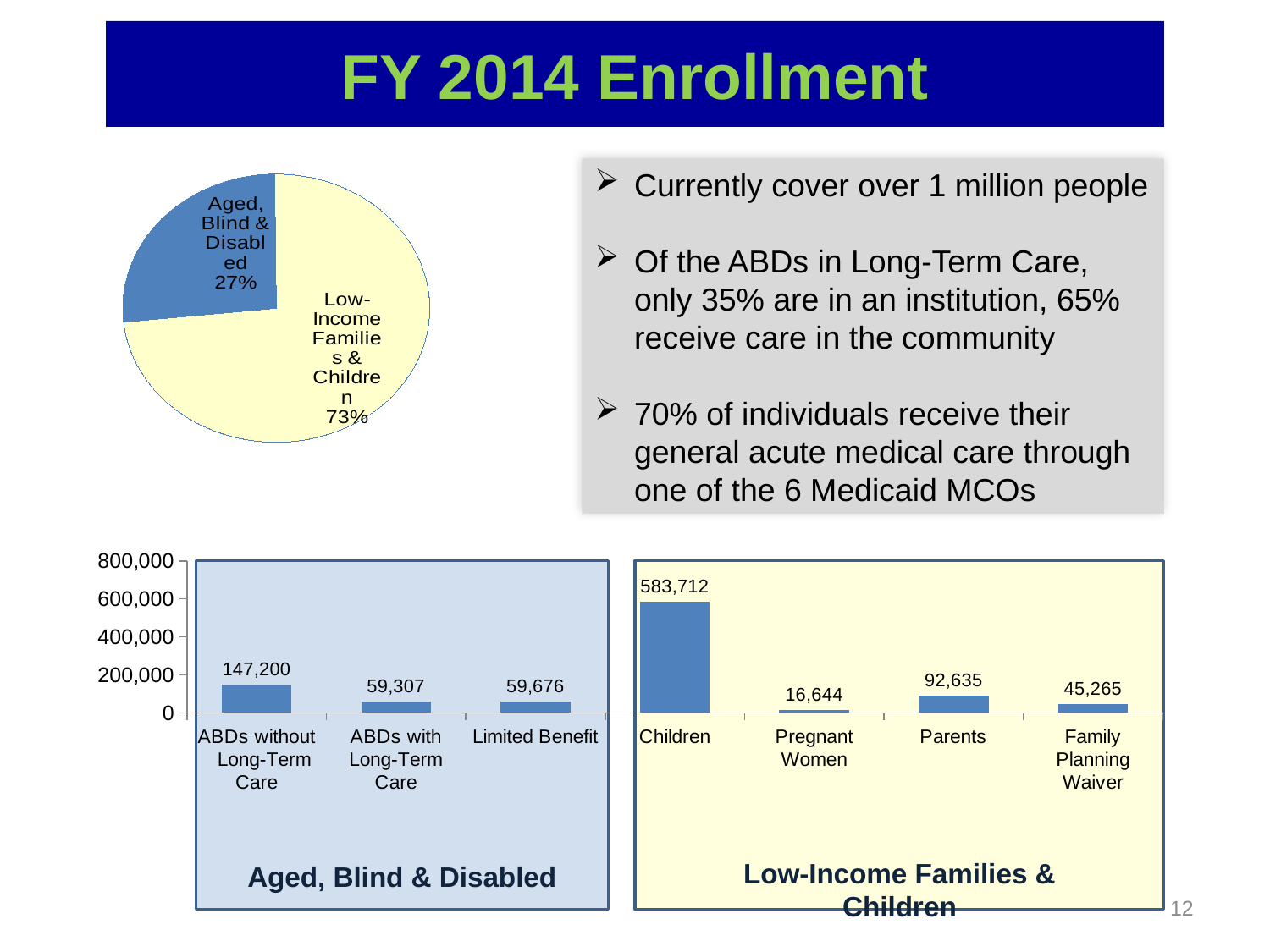
In the pie chart at the top left, which slice is larger, Aged, Blind & Disabled or Low-Income Families & Children? Low-Income Families & Children In the pie chart at the top left, what share of enrollment is Aged, Blind & Disabled? 27% In the bar chart at the bottom, how many categories are plotted? 7 In the bar chart at the bottom, what is the value for Children? 583,712 In the bar chart at the bottom, which category has the highest value? Children In the bar chart at the bottom, is the value for Children greater or less than 400,000? greater In the bar chart at the bottom, what is the difference between Parents and Family Planning Waiver? 47,370 In the bar chart at the bottom, which category has the lowest value? Pregnant Women In the bar chart at the bottom, what is the value for ABDs without Long-Term Care? 147,200 In the pie chart at the top left, what share of enrollment is Low-Income Families & Children? 73% In the bar chart at the bottom, what is the value for Pregnant Women? 16,644 What kind of chart is shown at the bottom of the slide? Bar chart